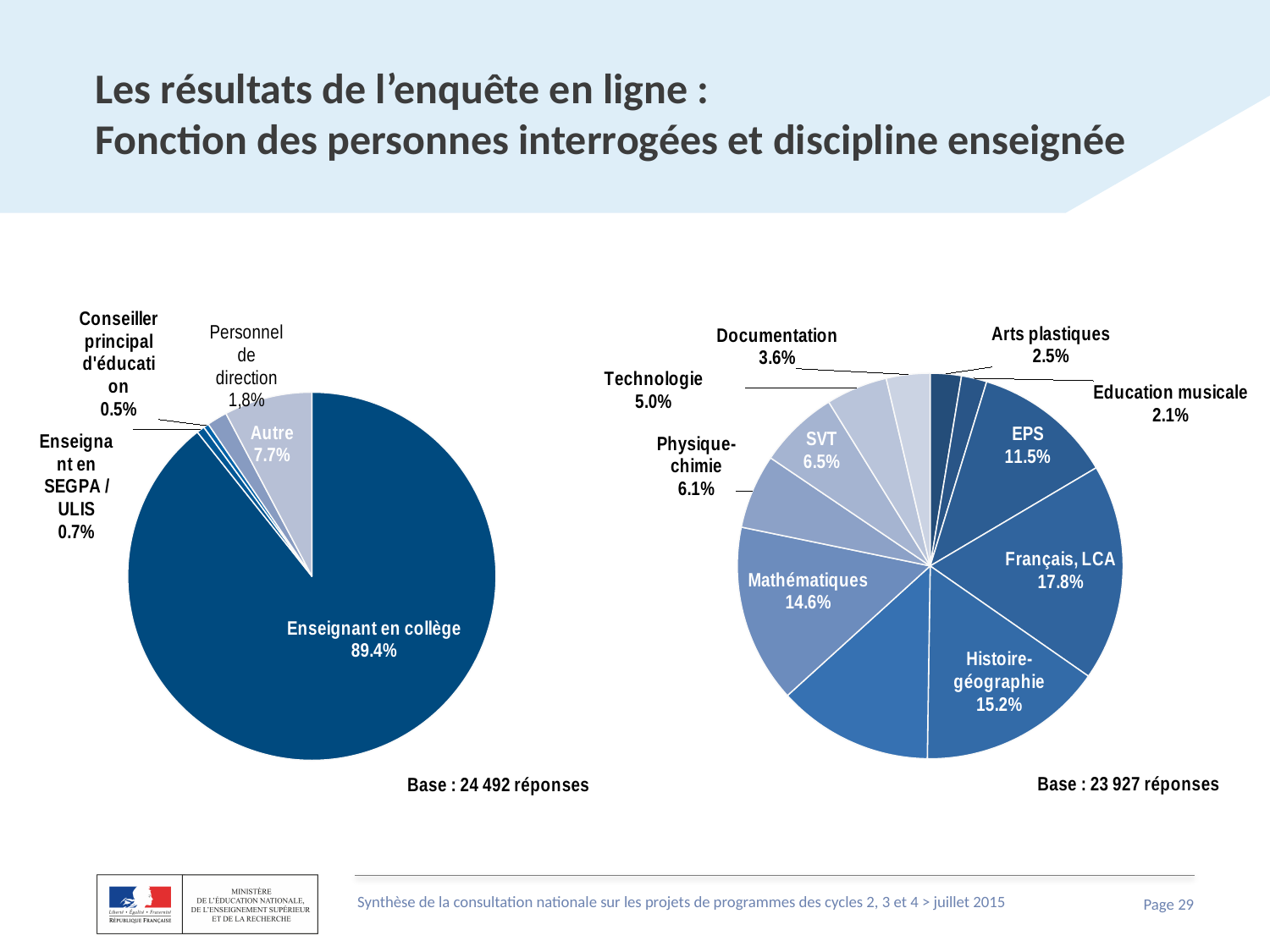
On the left pie chart, what percentage is shown for 'Autre'? 7.7% On the right pie chart, which is larger: the share for 'SVT' or for 'Physique-chimie'? SVT On the right pie chart, which labelled discipline has the smallest share? Education musicale On the right pie chart, what is the difference between the shares of 'Français, LCA' and 'Histoire-géographie'? 2.6% On the left pie chart, how many slices are there? 5 On the left pie chart, what percentage is shown for 'Personnel de direction'? 1,8% On the right pie chart, which labelled discipline has the largest share? Français, LCA What type of chart is used on the right side of the slide? Pie chart On the left pie chart, which category has the smallest share? Conseiller principal d'éducation On the left pie chart, what share of respondents are 'Enseignant en collège'? 89.4% What is the base (number of responses) stated under the right pie chart? 23 927 réponses On the right pie chart, what percentage is shown for 'Mathématiques'? 14.6%